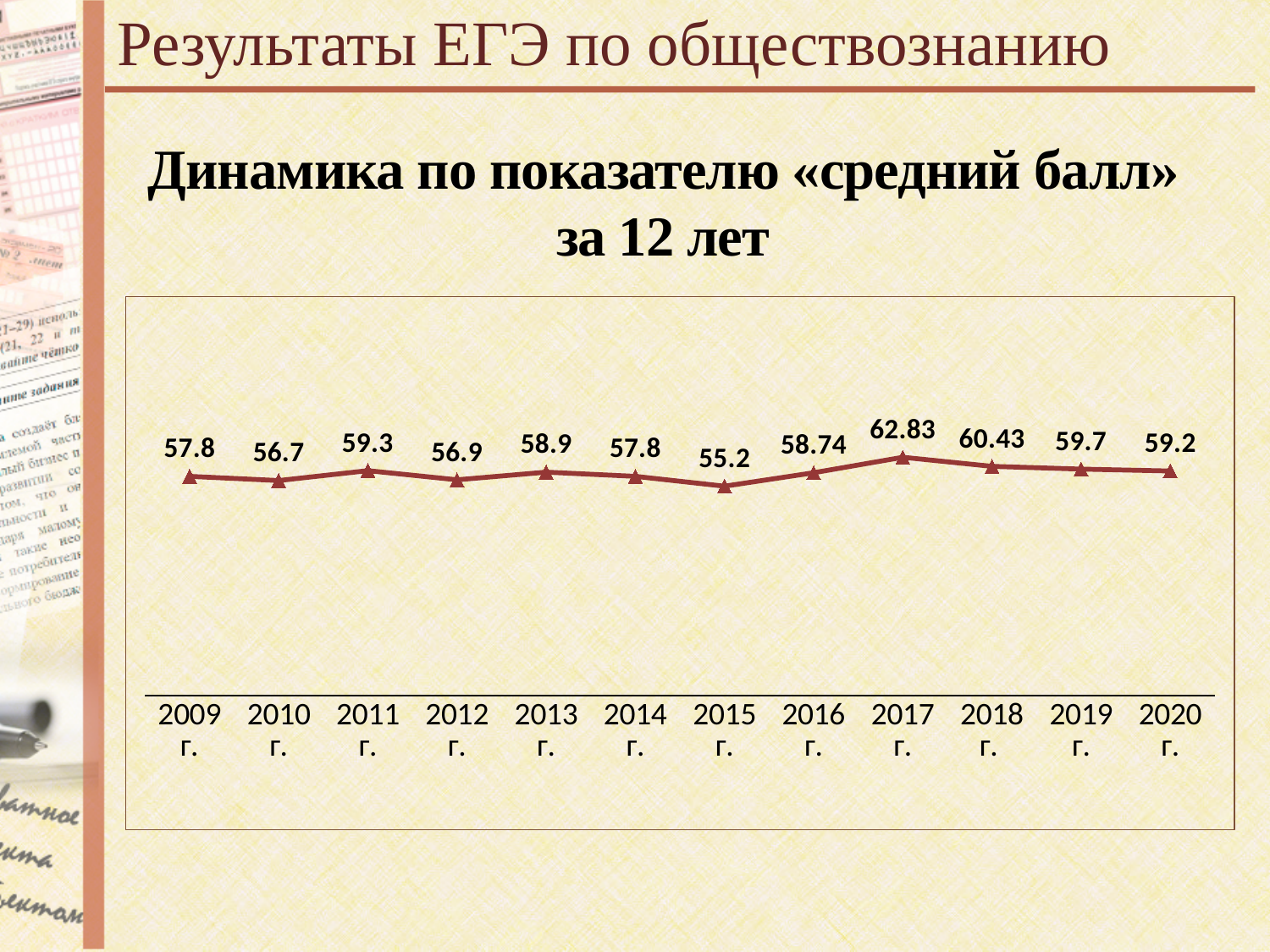
What is the average score for 2017? 62.83 What is the average score for 2015? 55.2 Does the average score rise or fall from 2015 to 2017? rise Which year has a higher average score, 2016 or 2019? 2019 What is the average score for 2011? 59.3 Which year has the lowest average score? 2015 Which year has the highest average score? 2017 What is the difference between the average scores for 2011 and 2010? 2.6 What is the average score for 2020? 59.2 What is the difference between the average scores for 2017 and 2018? 2.4 How many years are plotted on the chart? 12 What type of chart is shown on the slide? line chart